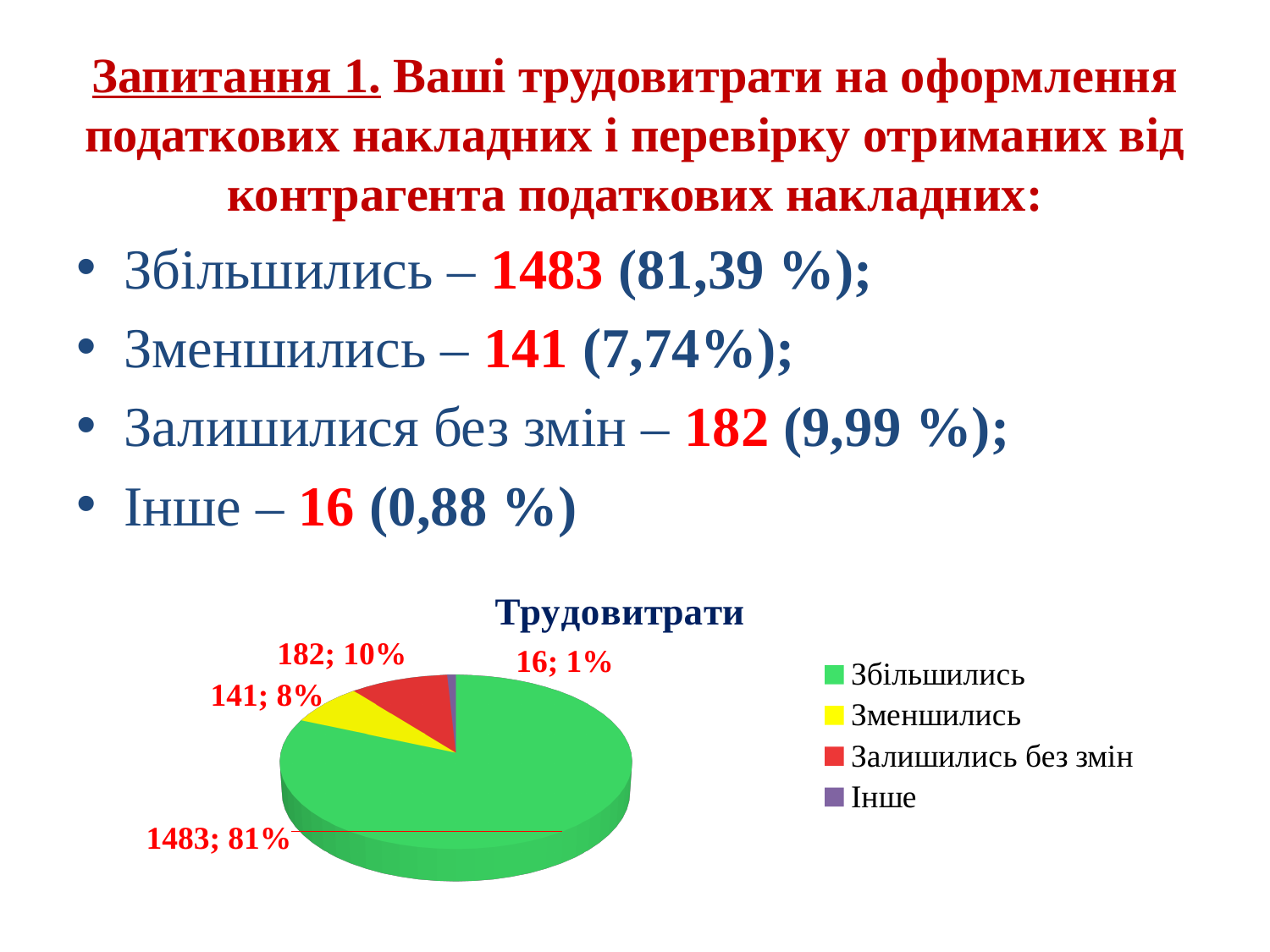
What is the value for Зменшились in the pie chart? 141 What is the value for Збільшились in the pie chart? 1483 What is the value for Залишились без змін in the pie chart? 182 What share of the pie does Залишились без змін take? 10% What is the title of the chart? Трудовитрати Which category has the largest slice of the pie? Збільшились What is the difference between the values for Залишились без змін and Зменшились? 41 What type of chart is shown on the slide? pie chart Which category has the smallest slice of the pie? Інше How many entries does the legend list? 4 How many slices does the pie chart have? 4 What is the value for Інше in the pie chart? 16